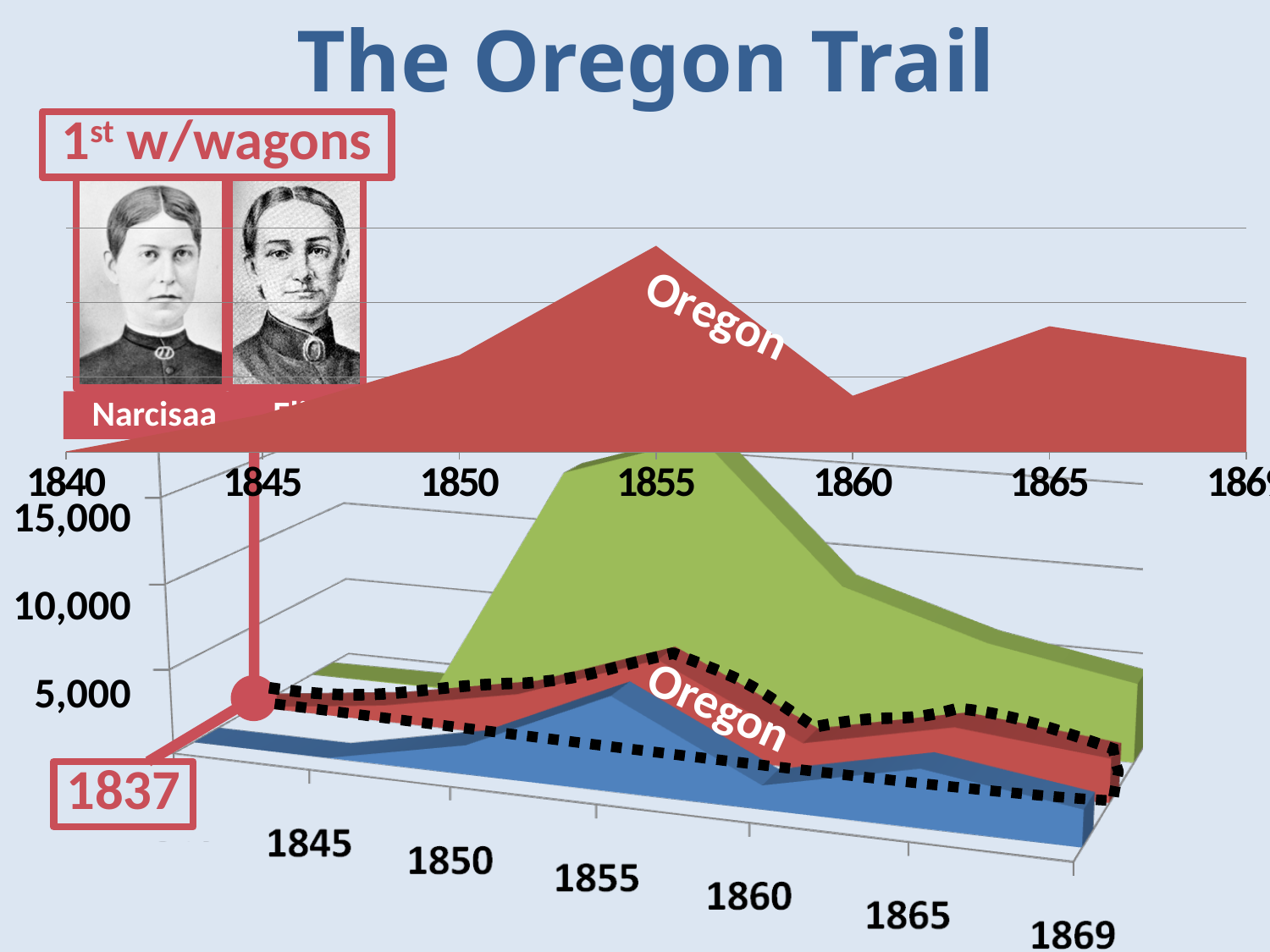
In the top chart, which year has the larger Oregon value, 1860 or 1865? 1865 What is the last year labelled on the horizontal axis of the bottom chart? 1869 In the top chart, in which year does the Oregon area reach its highest point? 1855 What kind of chart is the bottom chart on the slide? area chart How many coloured stacked areas are plotted in the bottom chart? 3 What is the highest value labelled on the vertical axis of the bottom chart? 15,000 In the top chart, which year has the larger Oregon value, 1855 or 1865? 1855 In the top chart, does the Oregon value rise or fall between 1840 and 1855? rise In the bottom chart, in which year does the green area reach its highest point? 1855 In the top chart, does the Oregon value rise or fall between 1855 and 1860? fall In the top chart, does the Oregon value rise or fall between 1860 and 1865? rise What kind of chart is the top chart on the slide? area chart